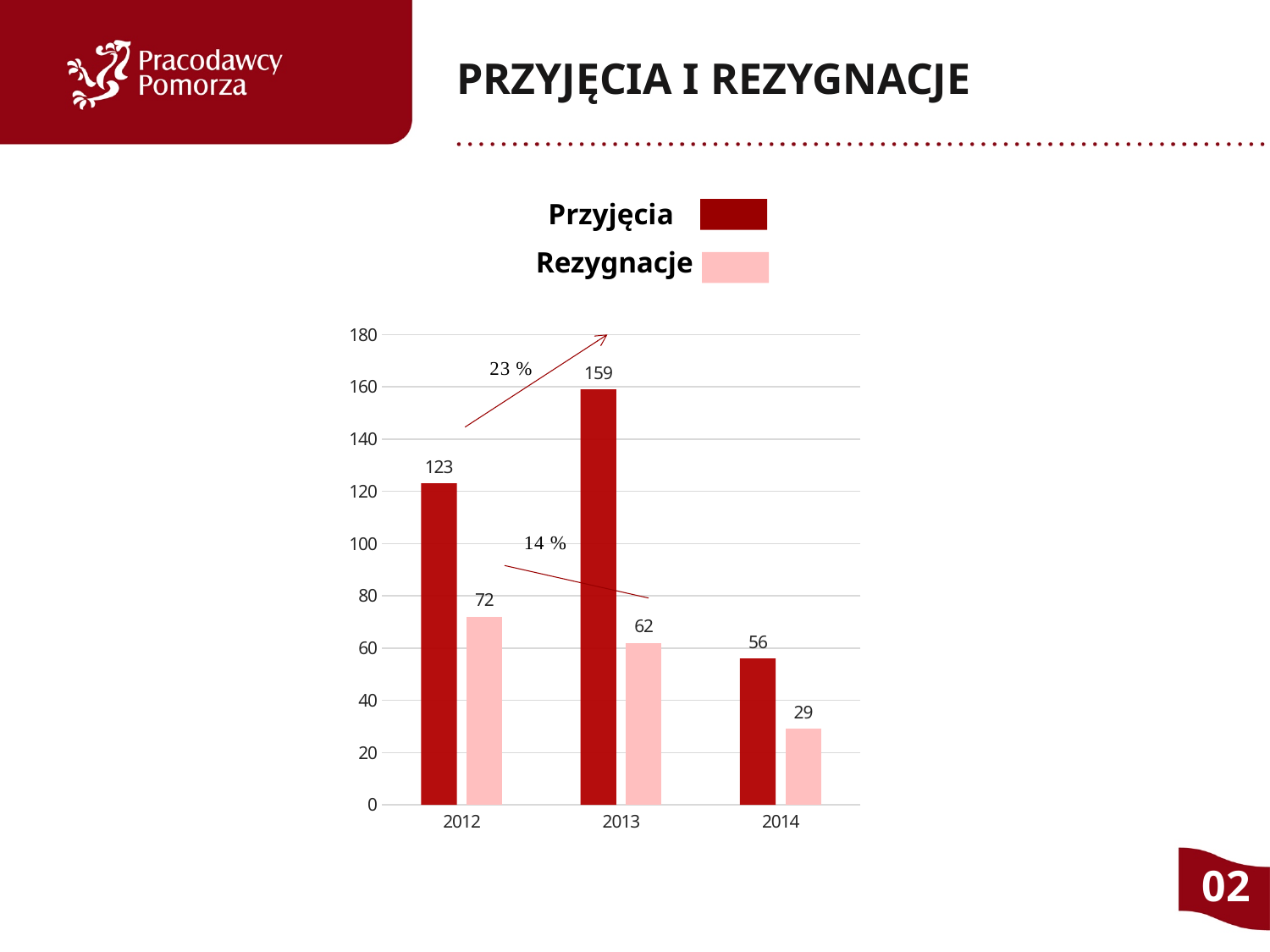
Which year has the highest value for Przyjęcia? 2013 What is the value of Rezygnacje in 2014? 29 How many years are shown on the x axis? 3 What is the difference between Przyjęcia in 2013 and Przyjęcia in 2012? 36 Which year has the lowest value for Rezygnacje? 2014 What is the value of Rezygnacje in 2012? 72 Which is larger: Przyjęcia in 2014 or Rezygnacje in 2012? Rezygnacje in 2012 What kind of chart is shown on the slide? Bar chart What is the title of the slide? PRZYJĘCIA I REZYGNACJE What is the difference between Przyjęcia and Rezygnacje in 2013? 97 What is the value of Przyjęcia in 2013? 159 How many series does the legend list? 2